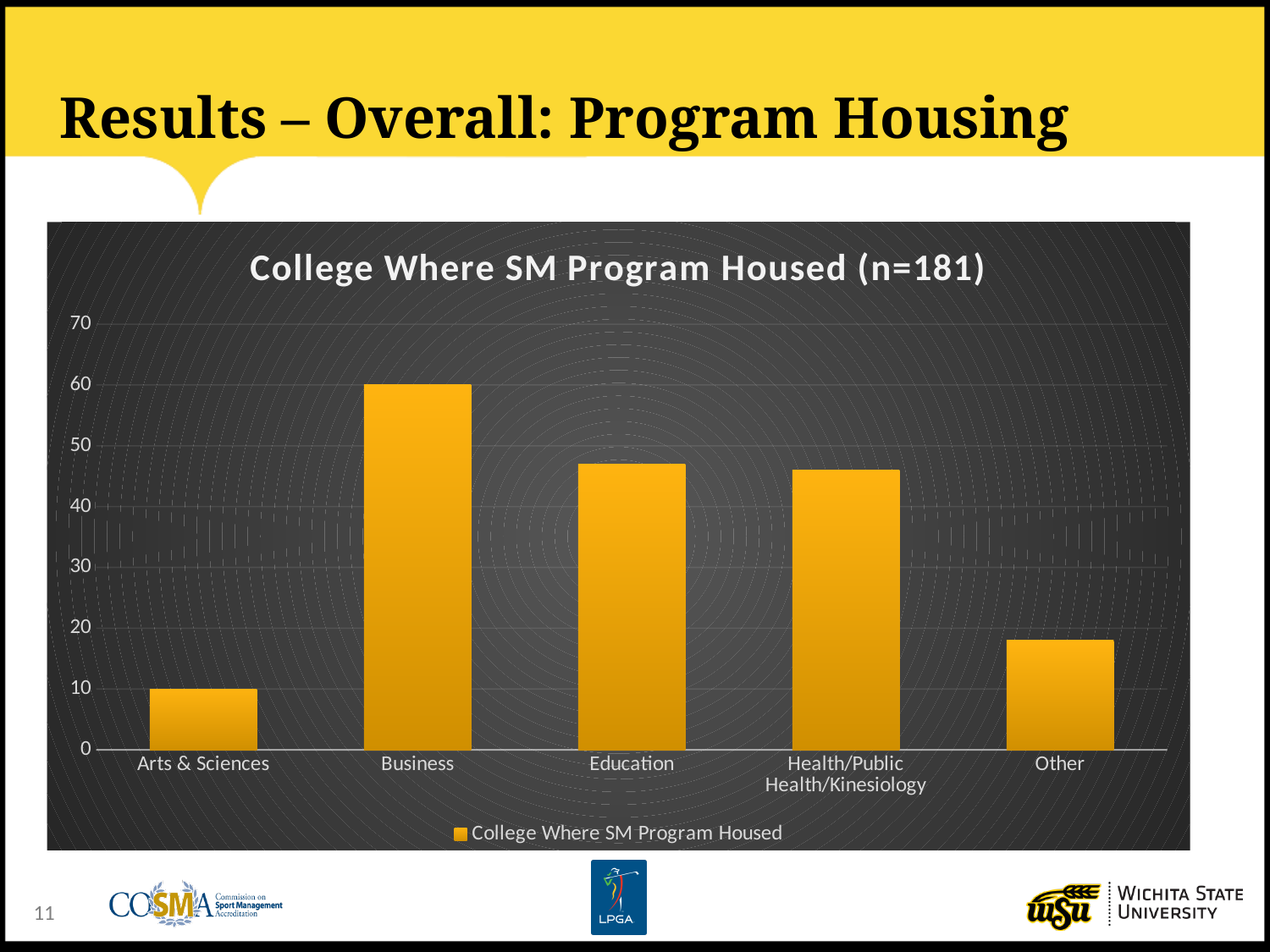
Which college category has the lowest bar? Arts & Sciences Is the value for Education greater or less than 40? greater How many series does the legend list? 1 Is the value for Other greater or less than 20? less Is the value for Health/Public Health/Kinesiology greater or less than 50? less What is the title of the chart? College Where SM Program Housed (n=181) What is the value for Arts & Sciences? 10 What is the value for Business? 60 What type of chart is shown on the slide? Bar chart How many categories are shown on the x axis of the chart? 5 Which is larger, the value for Other or the value for Arts & Sciences? Other Which college category has the highest bar? Business